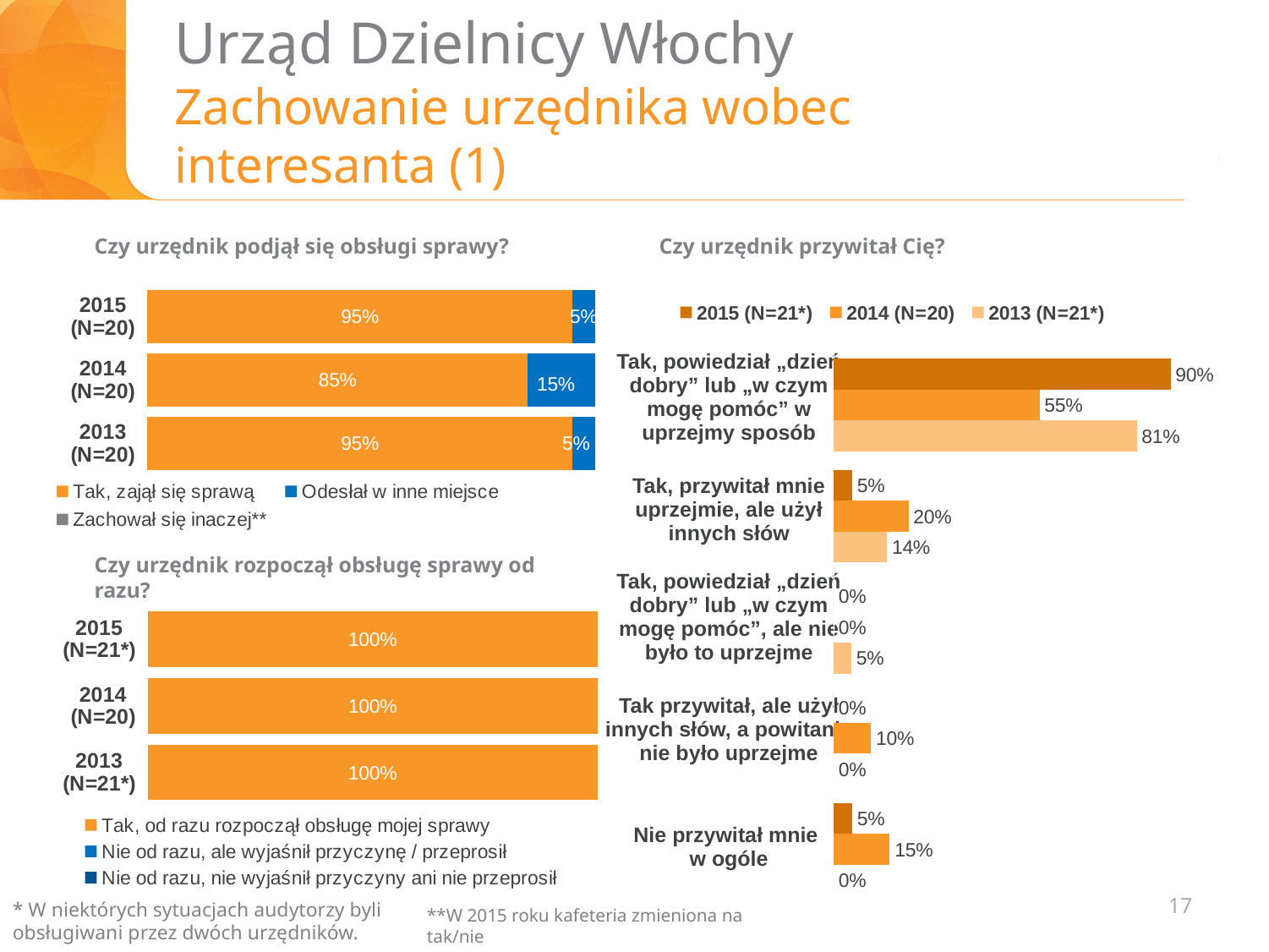
In the chart 'Czy urzędnik podjął się obsługi sprawy?', what percentage for 2014 (N=20) is 'Odesłał w inne miejsce'? 15% In the chart 'Czy urzędnik podjął się obsługi sprawy?', how many entries does the legend list? 3 In the chart 'Czy urzędnik przywitał Cię?', what is the 2014 (N=20) value for 'Nie przywitał mnie w ogóle'? 15% In the chart 'Czy urzędnik rozpoczął obsługę sprawy od razu?', what is the value for 2015 (N=21*)? 100% In the chart 'Czy urzędnik podjął się obsługi sprawy?', which year has the lowest share of 'Tak, zajął się sprawą'? 2014 (N=20) In the chart 'Czy urzędnik podjął się obsługi sprawy?', what percentage for 2014 (N=20) is 'Tak, zajął się sprawą'? 85% In the chart 'Czy urzędnik rozpoczął obsługę sprawy od razu?', how many year categories are shown? 3 In the chart 'Czy urzędnik przywitał Cię?', how many response categories are shown? 5 In the chart 'Czy urzędnik przywitał Cię?', what is the 2015 (N=21*) value for 'Tak, powiedział „dzień dobry” lub „w czym mogę pomóc” w uprzejmy sposób'? 90% What type of chart is 'Czy urzędnik przywitał Cię?'? Bar chart In the chart 'Czy urzędnik przywitał Cię?', which is larger for 'Tak, przywitał mnie uprzejmie, ale użył innych słów': the 2014 (N=20) value or the 2013 (N=21*) value? 2014 (N=20) In the chart 'Czy urzędnik przywitał Cię?', what is the difference between the 2015 (N=21*) and 2014 (N=20) values for 'Tak, powiedział „dzień dobry” lub „w czym mogę pomóc” w uprzejmy sposób'? 35 percentage points